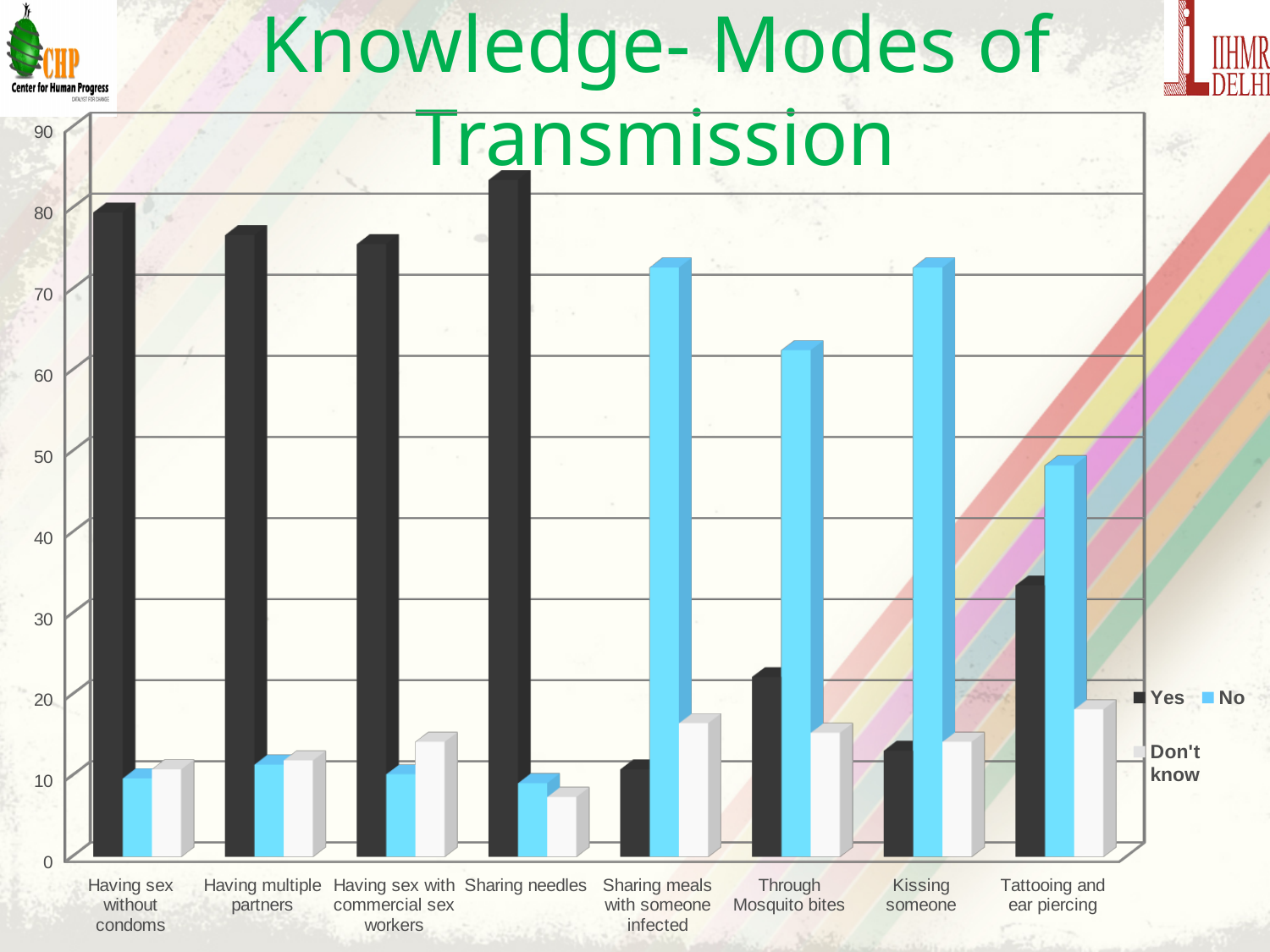
Which category has the highest value for the Yes series? Sharing needles How many categories are shown along the x axis of the chart? 8 How many series does the chart's legend list? 3 Which category has the lowest value for the Don't know series? Sharing needles What kind of chart is shown on the slide? bar chart Is the No value for Tattooing and ear piercing greater or less than 40? greater Is the Yes value for Having sex without condoms greater or less than 70? greater Which series is shown in light blue in the chart? No Is the No value for Sharing meals with someone infected greater or less than 60? greater What is the title of the chart? Knowledge- Modes of Transmission For Tattooing and ear piercing, which is larger: the Yes value or the No value? No